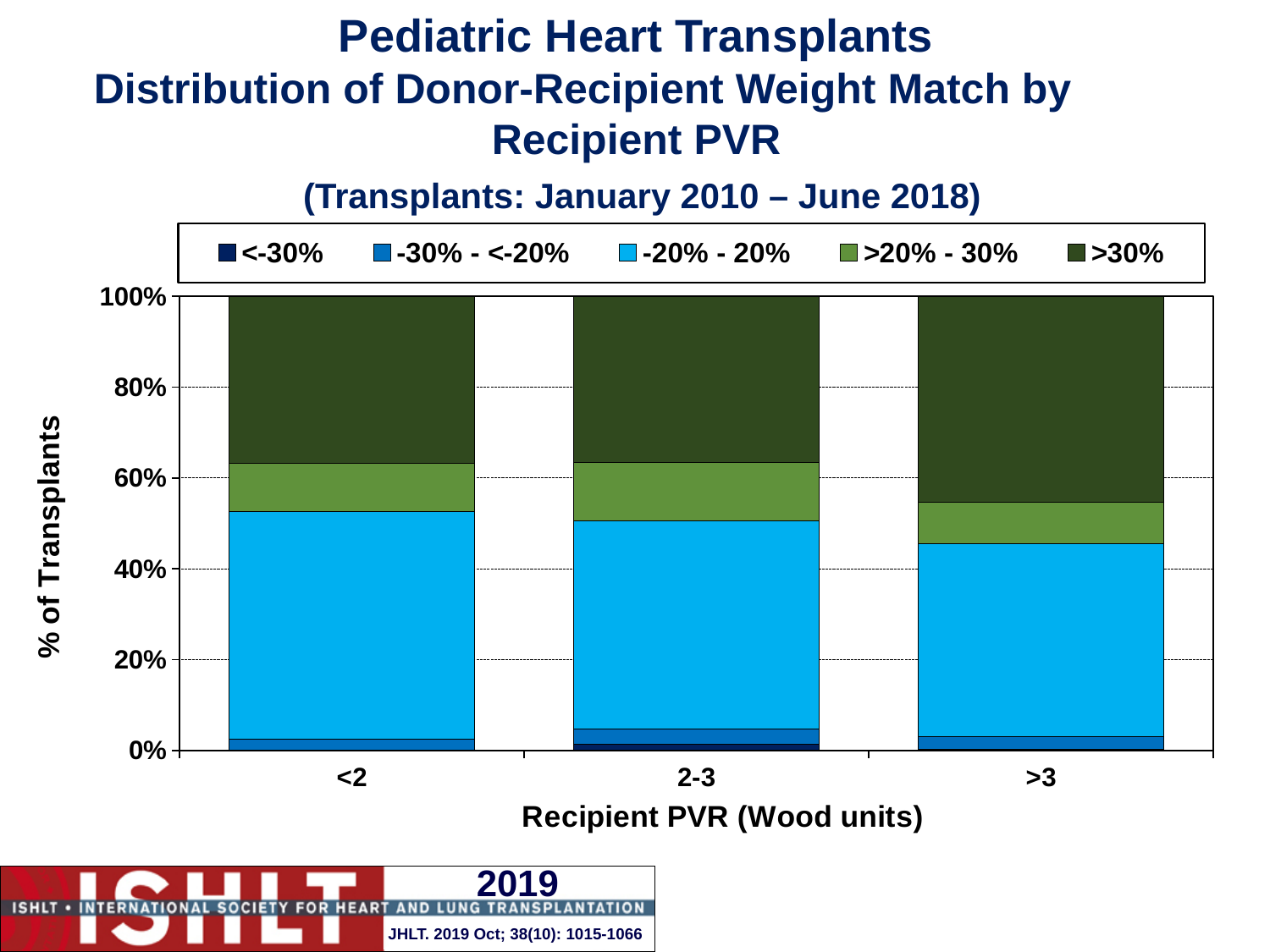
How many series does the legend list? 5 Which Recipient PVR category has the largest >30% segment? >3 Which Recipient PVR category has the smallest -20% - 20% segment? >3 What is the title of the x axis? Recipient PVR (Wood units) Does the -20% - 20% segment rise or fall moving from <2 to >3 along the x axis? fall What kind of chart is shown on the slide? Stacked bar chart How many Recipient PVR categories are shown on the x axis? 3 Is the >30% segment larger for the <2 category or the >3 category? >3 Is the -20% - 20% segment for the >3 category greater or less than 50%? less Is the >30% segment for the >3 category greater or less than 40%? greater Is the -20% - 20% segment for the <2 category greater or less than 40%? greater What is the title of the y axis? % of Transplants